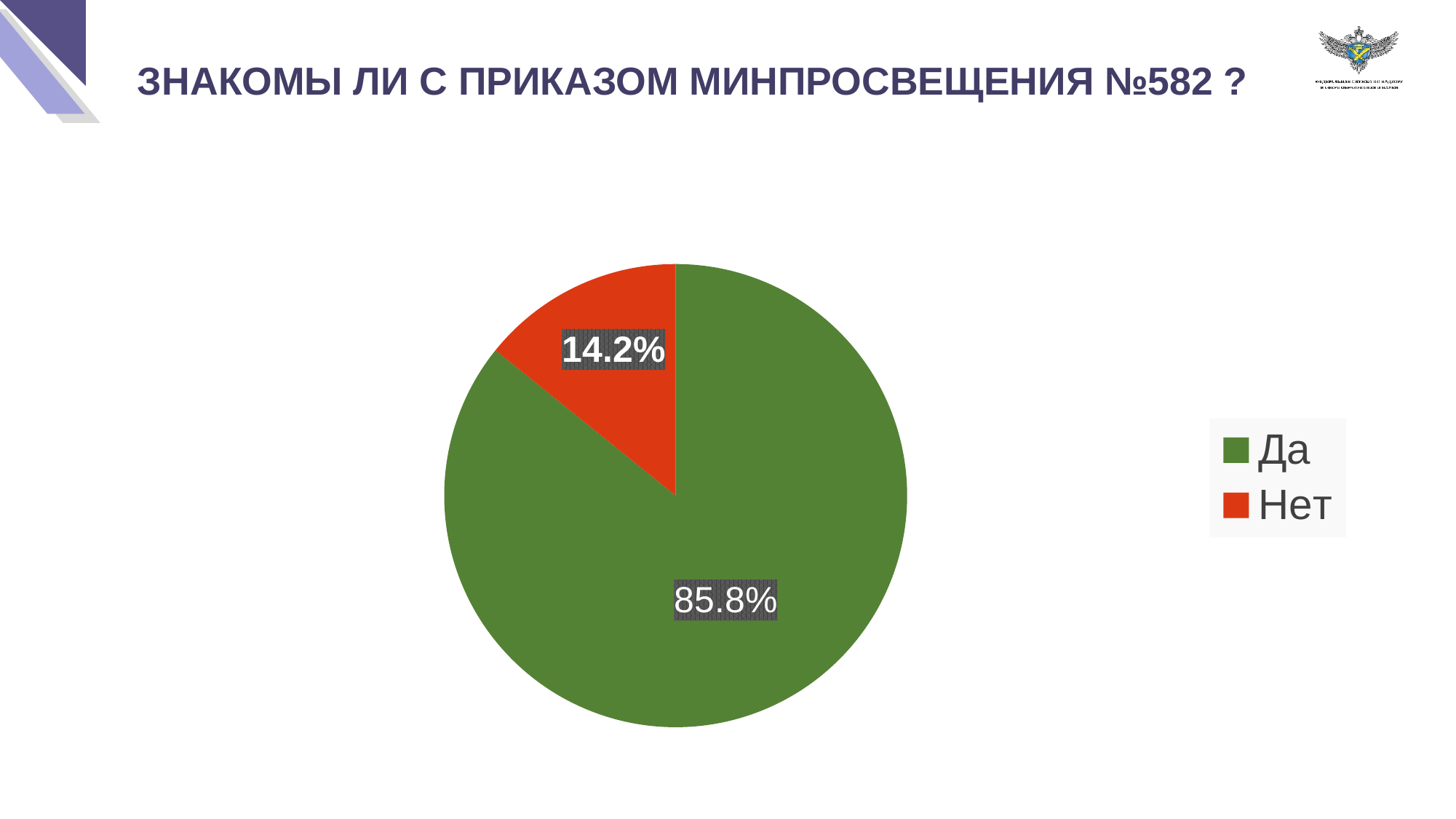
What share of the pie does "Нет" take? 14.2% Which slice of the pie is the largest? Да What is the difference in percentage points between the "Да" and "Нет" slices? 71.6 What is the title of the slide above the chart? ЗНАКОМЫ ЛИ С ПРИКАЗОМ МИНПРОСВЕЩЕНИЯ №582 ? What colour is the "Нет" slice? red Which is larger, the "Да" slice or the "Нет" slice? Да Which slice of the pie is the smallest? Нет How many entries does the legend list? 2 What share of the pie does "Да" take? 85.8% What kind of chart is shown on the slide? pie chart How many slices does the pie chart have? 2